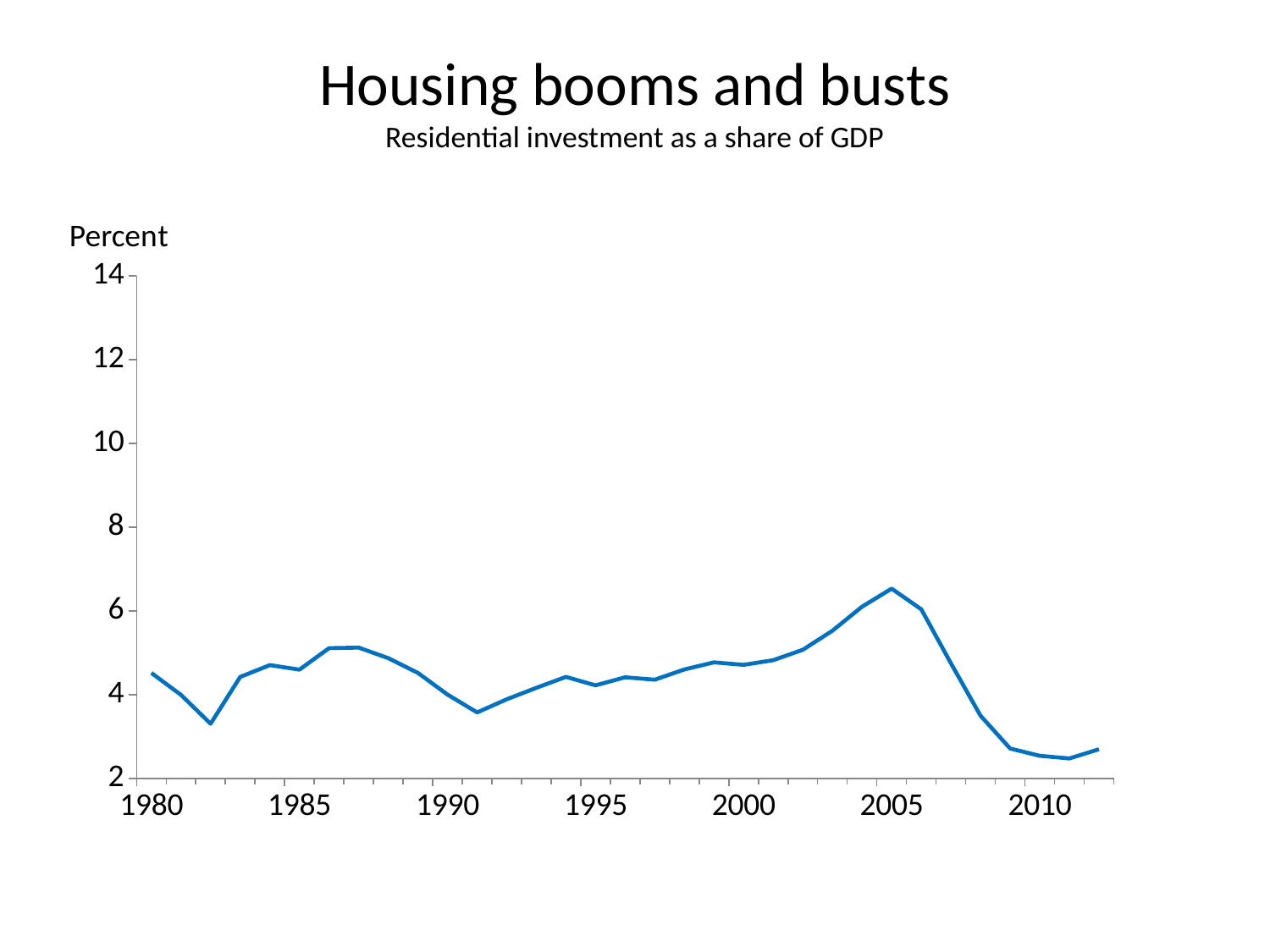
Which year has the larger value, 1987 or 2005? 2005 In which year does residential investment as a share of GDP reach its lowest value? 2011 Is the value for 2011 greater or less than 4? less What is the title of the chart? Housing booms and busts In which year does residential investment as a share of GDP reach its highest value? 2005 Is the value for 2009 greater or less than 4? less Does the value rise or fall between 2005 and 2009? fall Is the value for 1980 greater or less than 4? greater What is the label on the vertical axis? Percent What kind of chart is shown on the slide? line chart Which year has the larger value, 1982 or 2011? 1982